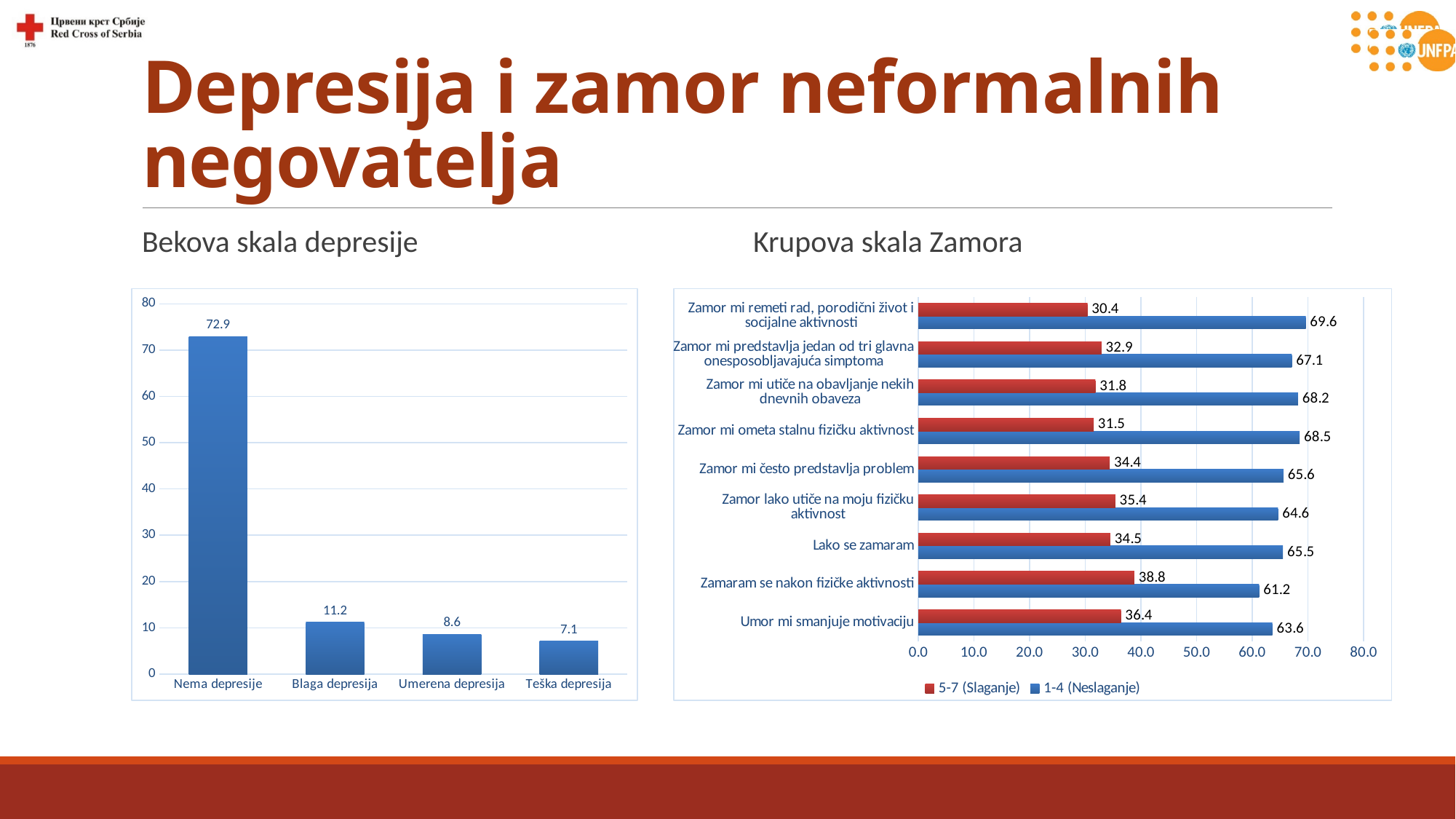
In the Bekova skala depresije chart, do the values rise or fall from left to right? fall In the Krupova skala Zamora chart, which item has the highest 5-7 (Slaganje) value? Zamaram se nakon fizičke aktivnosti In the Krupova skala Zamora chart, how many series does the legend list? 2 In the Krupova skala Zamora chart, which is larger for Umor mi smanjuje motivaciju: 5-7 (Slaganje) or 1-4 (Neslaganje)? 1-4 (Neslaganje) What kind of chart is the Krupova skala Zamora chart? bar chart In the Bekova skala depresije chart, what is the difference between Blaga depresija and Umerena depresija? 2.6 In the Bekova skala depresije chart, what is the value for Nema depresije? 72.9 In the Krupova skala Zamora chart, what is the 1-4 (Neslaganje) value for Zamor mi remeti rad, porodični život i socijalne aktivnosti? 69.6 In the Krupova skala Zamora chart, what is the 5-7 (Slaganje) value for Zamaram se nakon fizičke aktivnosti? 38.8 In the Bekova skala depresije chart, which category has the lowest value? Teška depresija In the Bekova skala depresije chart, how many categories are shown? 4 In the Krupova skala Zamora chart, which item has the lowest 1-4 (Neslaganje) value? Zamaram se nakon fizičke aktivnosti